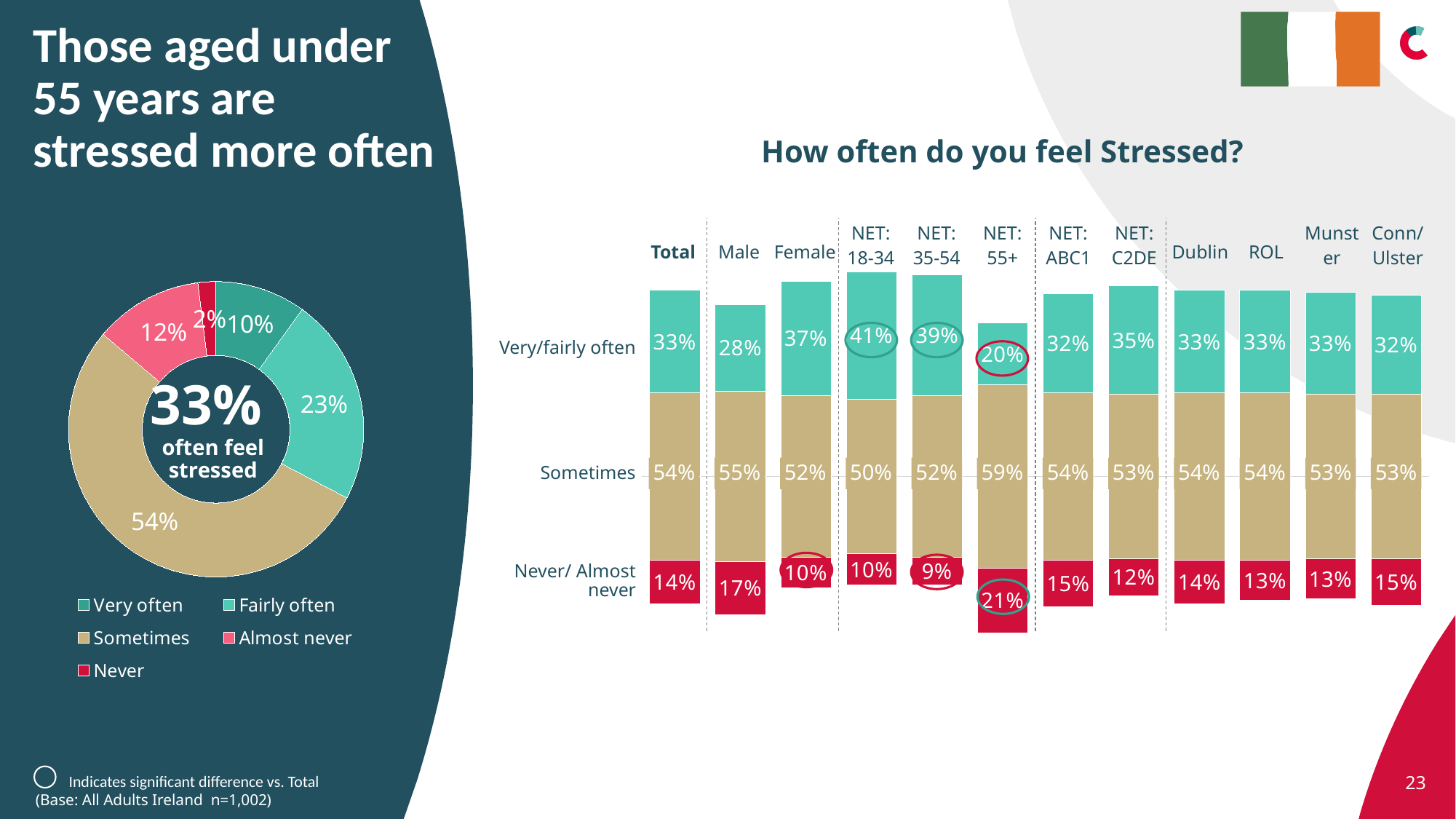
In the 'How often do you feel Stressed?' chart, what is the 'Very/fairly often' value for NET: 18-34? 41% In the 'How often do you feel Stressed?' chart, which has a higher 'Never/ Almost never' value, Male or Female? Male In the 'How often do you feel Stressed?' chart, what is the 'Never/ Almost never' value for NET: 55+? 21% In the donut chart on the left, what share of respondents say they feel stressed 'Sometimes'? 54% What kind of chart is 'How often do you feel Stressed?'? Stacked bar chart In the 'How often do you feel Stressed?' chart, what is the 'Sometimes' value for NET: 55+? 59% In the donut chart on the left, what percentage say they 'Never' feel stressed? 2% In the donut chart on the left, how many categories does the legend list? 5 In the 'How often do you feel Stressed?' chart, what is the difference between the 'Very/fairly often' values for Female and Male? 9% In the 'How often do you feel Stressed?' chart, which group has the lowest 'Very/fairly often' value? NET: 55+ In the 'How often do you feel Stressed?' chart, how many groups (bars) are shown along the x axis? 12 In the donut chart on the left, which category has the largest slice? Sometimes